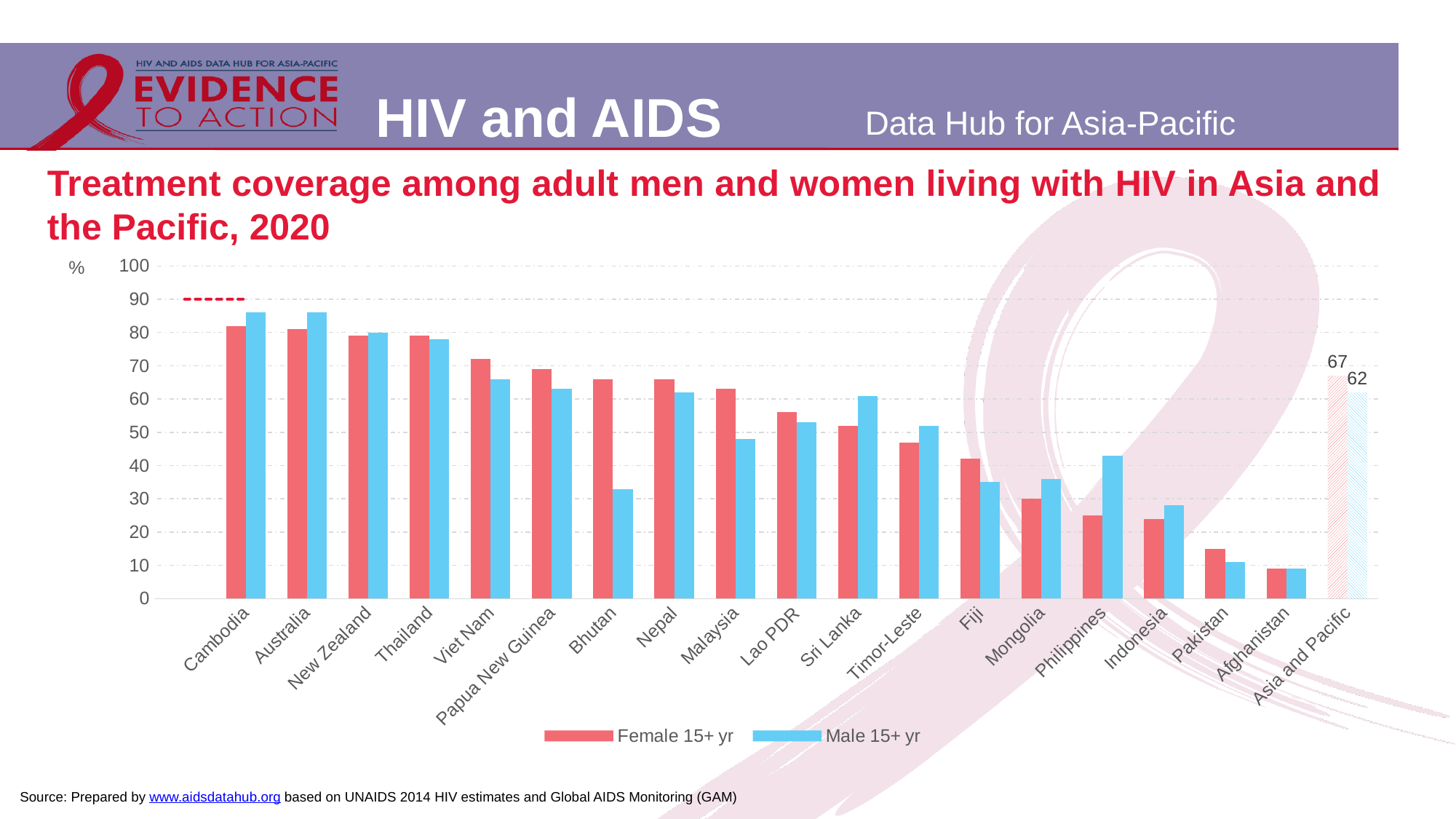
What kind of chart is shown on the slide? Bar chart Is the Female 15+ yr value for Mongolia greater or less than 40? less Is the Male 15+ yr value for Bhutan greater or less than 40? less For Asia and Pacific, which is larger: the Female 15+ yr value or the Male 15+ yr value? Female 15+ yr Which country has the lowest Female 15+ yr treatment coverage? Afghanistan What is the Female 15+ yr treatment coverage value shown for Asia and Pacific? 67 What is the Male 15+ yr treatment coverage value shown for Asia and Pacific? 62 What is the difference between the Female 15+ yr and Male 15+ yr values for Asia and Pacific? 5 For Bhutan, which is larger: the Female 15+ yr bar or the Male 15+ yr bar? Female 15+ yr How many series does the legend list? 2 Is the Male 15+ yr value for Cambodia greater or less than 80? greater How many categories are shown on the x axis? 19